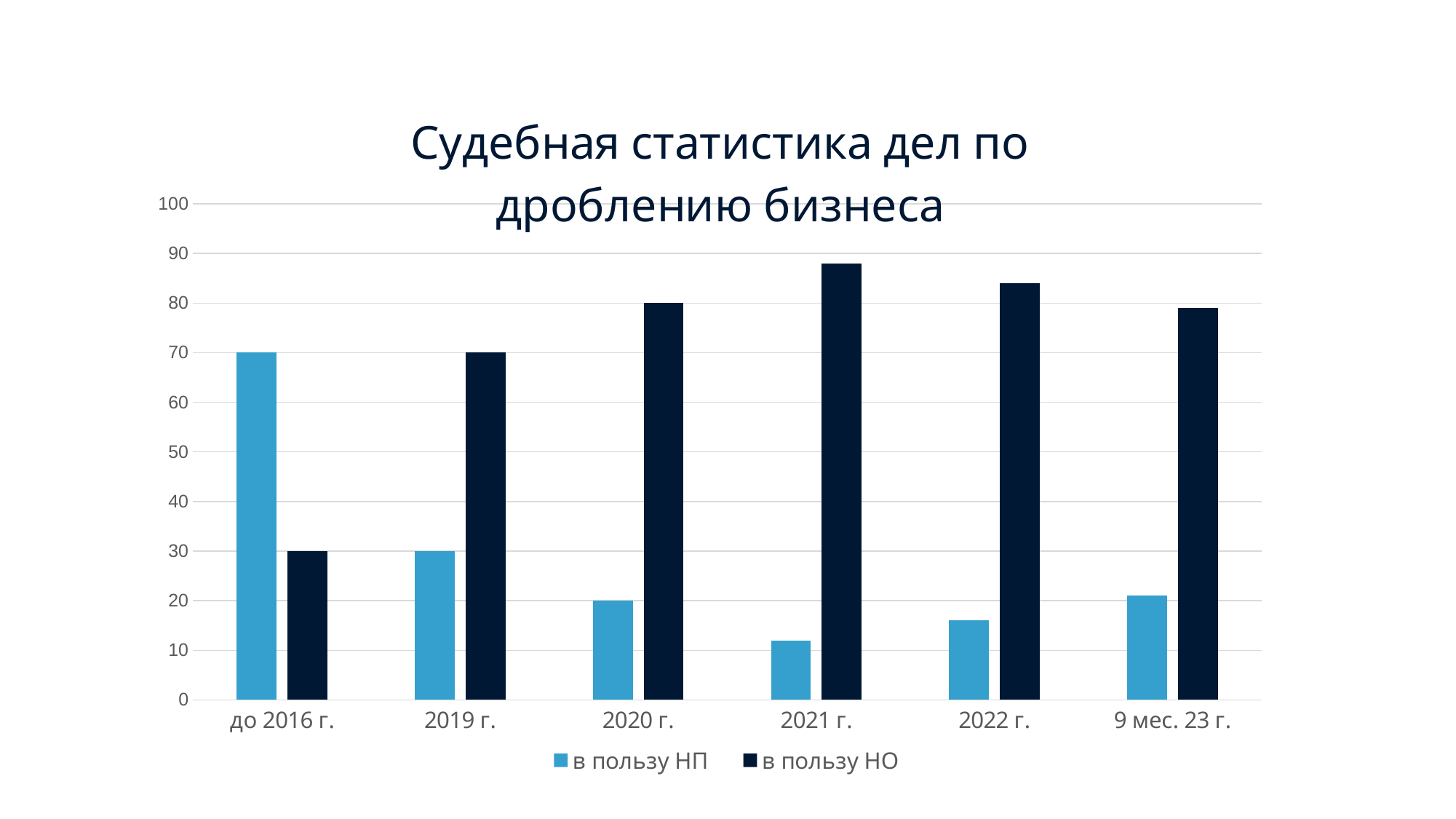
What is the value for "в пользу НО" in the category "2019 г."? 70 What is the value for "в пользу НП" in the category "до 2016 г."? 70 Which is larger in the category "2019 г.": "в пользу НП" or "в пользу НО"? в пользу НО In which category is the value for "в пользу НО" the highest? 2021 г. Is the value for "в пользу НО" in "2022 г." greater or less than 80? greater How many categories are shown on the x axis? 6 What is the title of the chart? Судебная статистика дел по дроблению бизнеса What is the difference between "в пользу НП" and "в пользу НО" in the category "до 2016 г."? 40 In which category is the value for "в пользу НП" the lowest? 2021 г. What is the value for "в пользу НО" in the category "2020 г."? 80 What kind of chart is shown on the slide? bar chart How many series does the legend list? 2